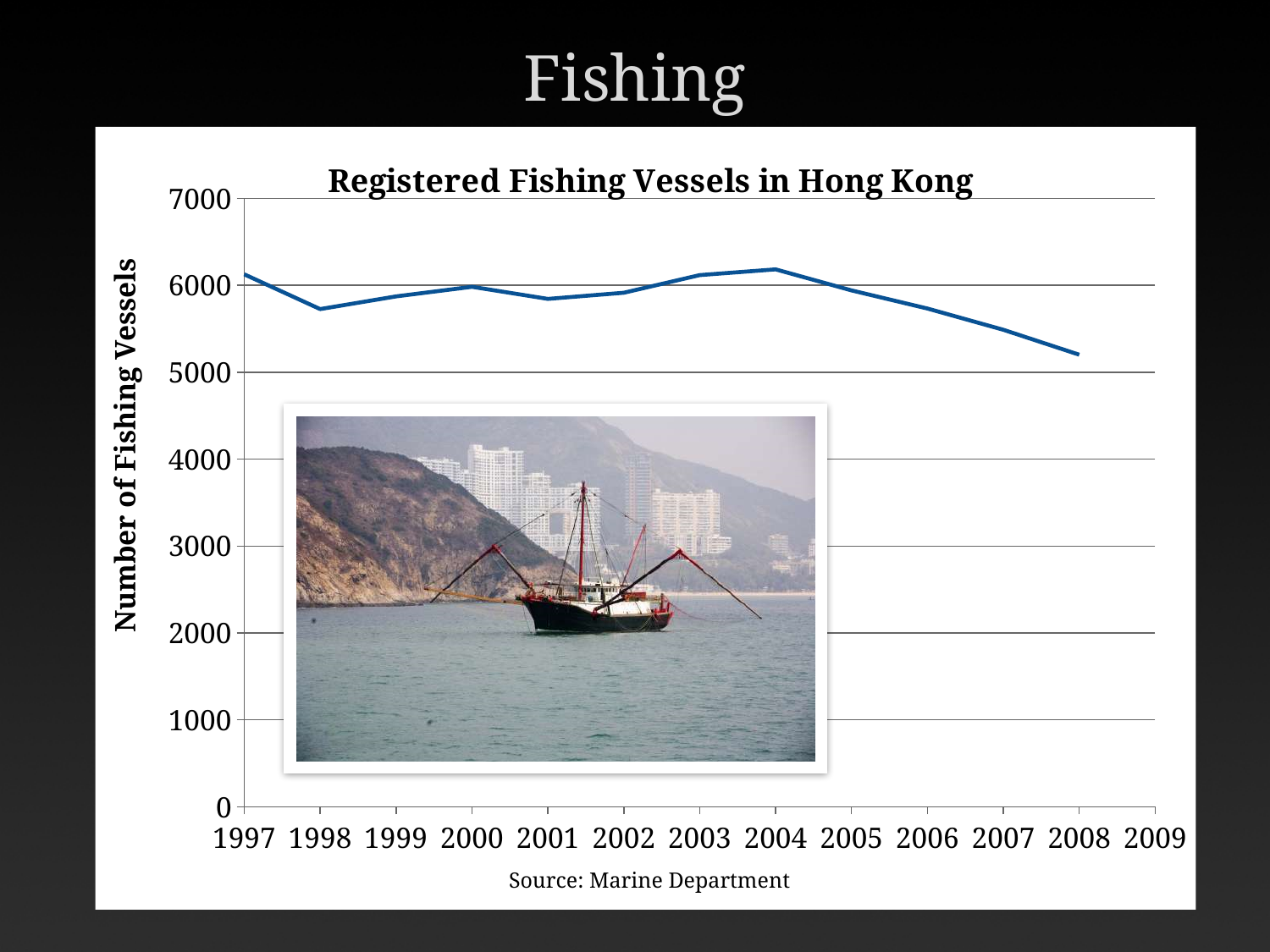
In which year is the number of registered fishing vessels lowest? 2008 Is the value for 2008 greater or less than 5000? greater Which year has more registered fishing vessels, 2004 or 2008? 2004 Does the number of registered fishing vessels rise or fall from 2004 to 2008? Fall What is the label on the vertical axis of the chart? Number of Fishing Vessels How many years have a plotted value on the line? 12 Is the value for 2008 greater or less than 6000? less Is the value for 2004 greater or less than 6000? greater What is the title of the chart? Registered Fishing Vessels in Hong Kong What type of chart is shown on the slide? Line chart In which year is the number of registered fishing vessels highest? 2004